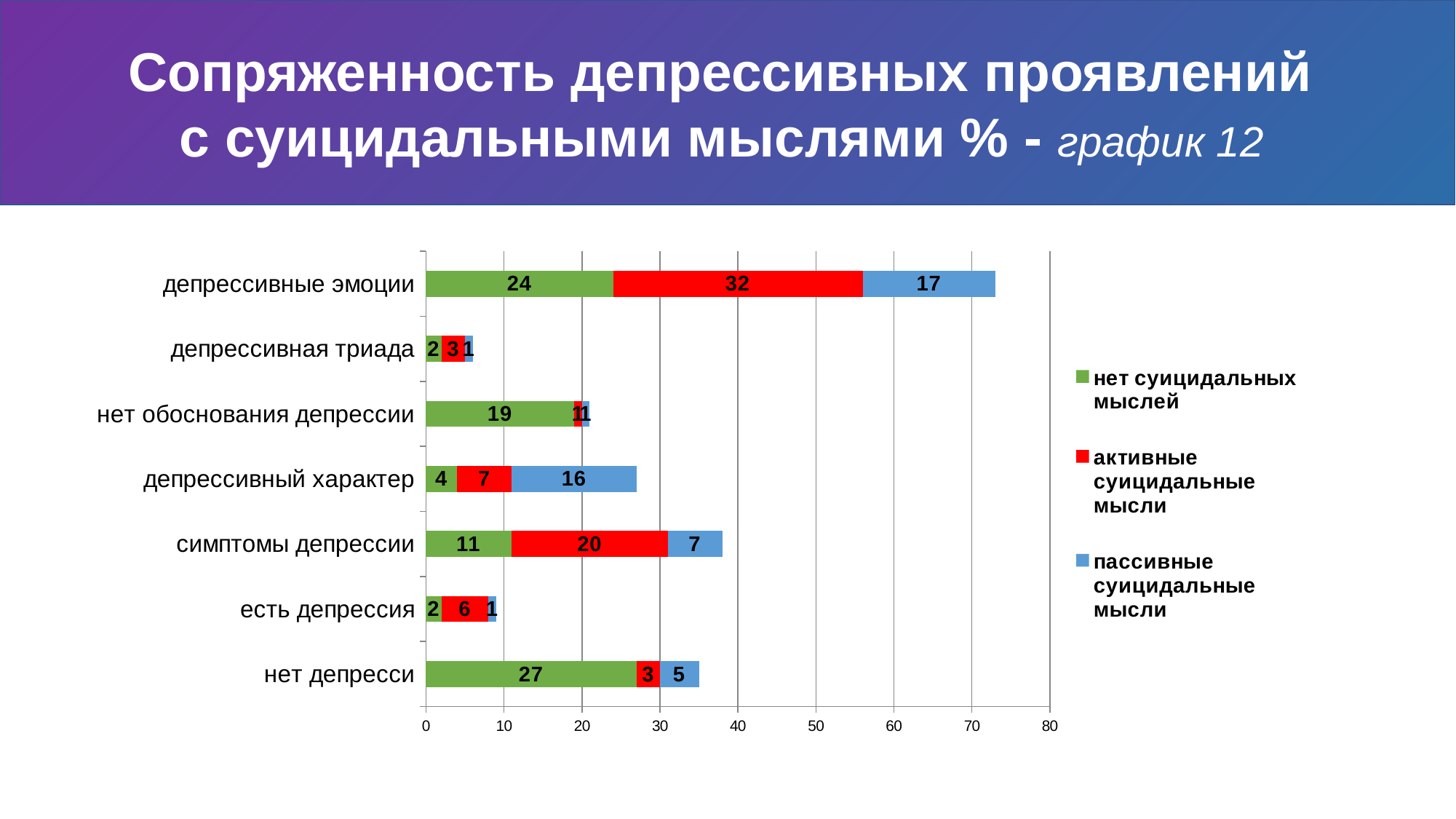
Which is larger for 'нет депресси': 'нет суицидальных мыслей' or 'пассивные суицидальные мысли'? нет суицидальных мыслей How many series does the legend list? 3 Which category has the highest value for 'активные суицидальные мысли'? депрессивные эмоции What kind of chart is shown on the slide? stacked bar chart What is the value of 'пассивные суицидальные мысли' for 'депрессивный характер'? 16 How many categories are plotted on the chart? 7 What is the total of the stacked bar for 'депрессивные эмоции'? 73 Which colour represents 'активные суицидальные мысли' in the legend? red What is the total of the stacked bar for 'симптомы депрессии'? 38 What is the difference between 'активные суицидальные мысли' and 'нет суицидальных мыслей' for 'симптомы депрессии'? 9 What is the value of 'активные суицидальные мысли' for 'депрессивные эмоции'? 32 What is the value of 'нет суицидальных мыслей' for 'нет депресси'? 27